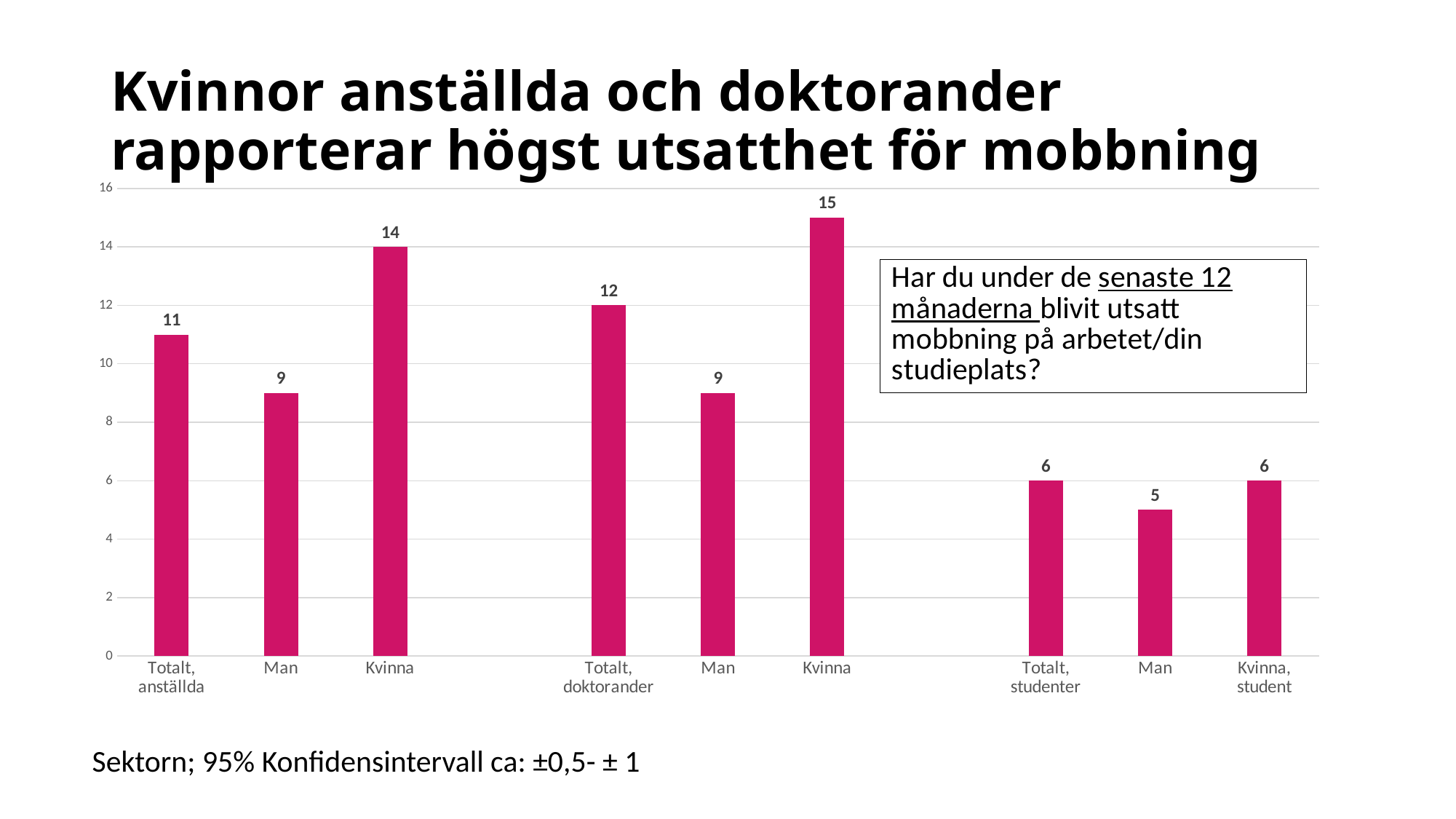
Which category has the highest value in the chart? Kvinna (doktorander group) What is the difference between the "Kvinna" bar in the anställda group and the "Man" bar in the anställda group? 5 What is the maximum value shown on the vertical axis? 16 What is the difference between the "Kvinna" bar in the doktorander group (15) and the "Totalt, doktorander" bar? 3 What is the value for "Totalt, anställda"? 11 What is the value for "Kvinna, student"? 6 How many bars are plotted in the chart? 9 What is the value for "Totalt, doktorander"? 12 What kind of chart is shown on the slide? Bar chart Which is larger: the value for "Totalt, anställda" or the value for "Totalt, studenter"? Totalt, anställda What is the value for the "Man" bar in the studenter group (the bar between "Totalt, studenter" and "Kvinna, student")? 5 Which category has the lowest value in the chart? Man (studenter group)